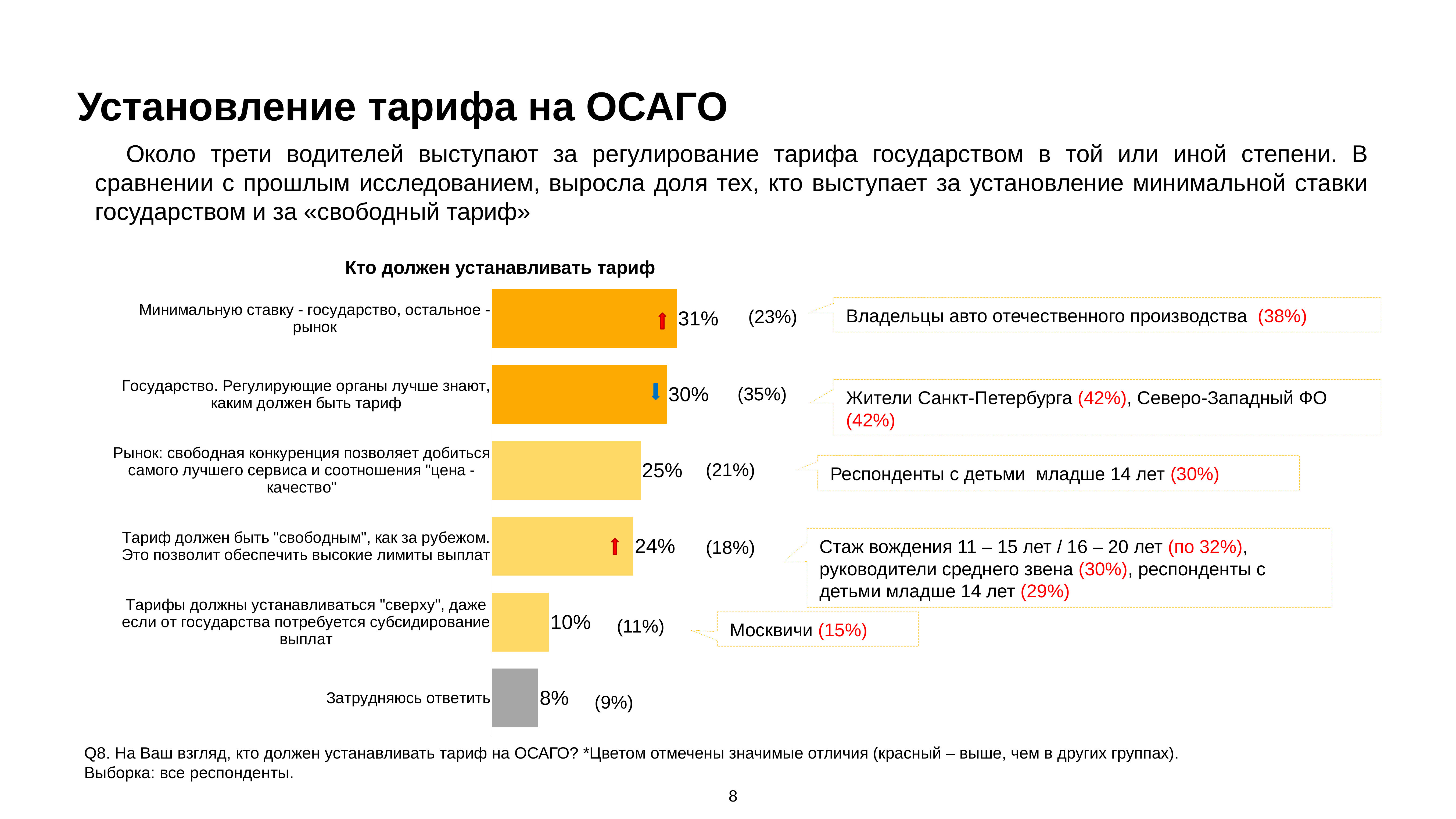
What colour is the bar for "Затрудняюсь ответить"? Grey What is the value for "Государство. Регулирующие органы лучше знают, каким должен быть тариф"? 30% Which is larger: the value for "Рынок: свободная конкуренция..." or the value for "Тарифы должны устанавливаться "сверху"..."? Рынок: свободная конкуренция... Which category has the lowest value in the chart? Затрудняюсь ответить What is the value for "Минимальную ставку - государство, остальное - рынок"? 31% What is the value for "Затрудняюсь ответить"? 8% Which category has the highest value in the chart? Минимальную ставку - государство, остальное - рынок What is the difference between the value for "Рынок: свободная конкуренция..." (25%) and "Тарифы должны устанавливаться "сверху"..." (10%)? 15% What kind of chart is shown under the title "Кто должен устанавливать тариф"? Bar chart What is the value for "Тариф должен быть "свободным", как за рубежом"? 24% How many categories are plotted in the chart "Кто должен устанавливать тариф"? 6 What previous-wave value is shown in parentheses next to the 30% bar for "Государство. Регулирующие органы лучше знают..."? (35%)